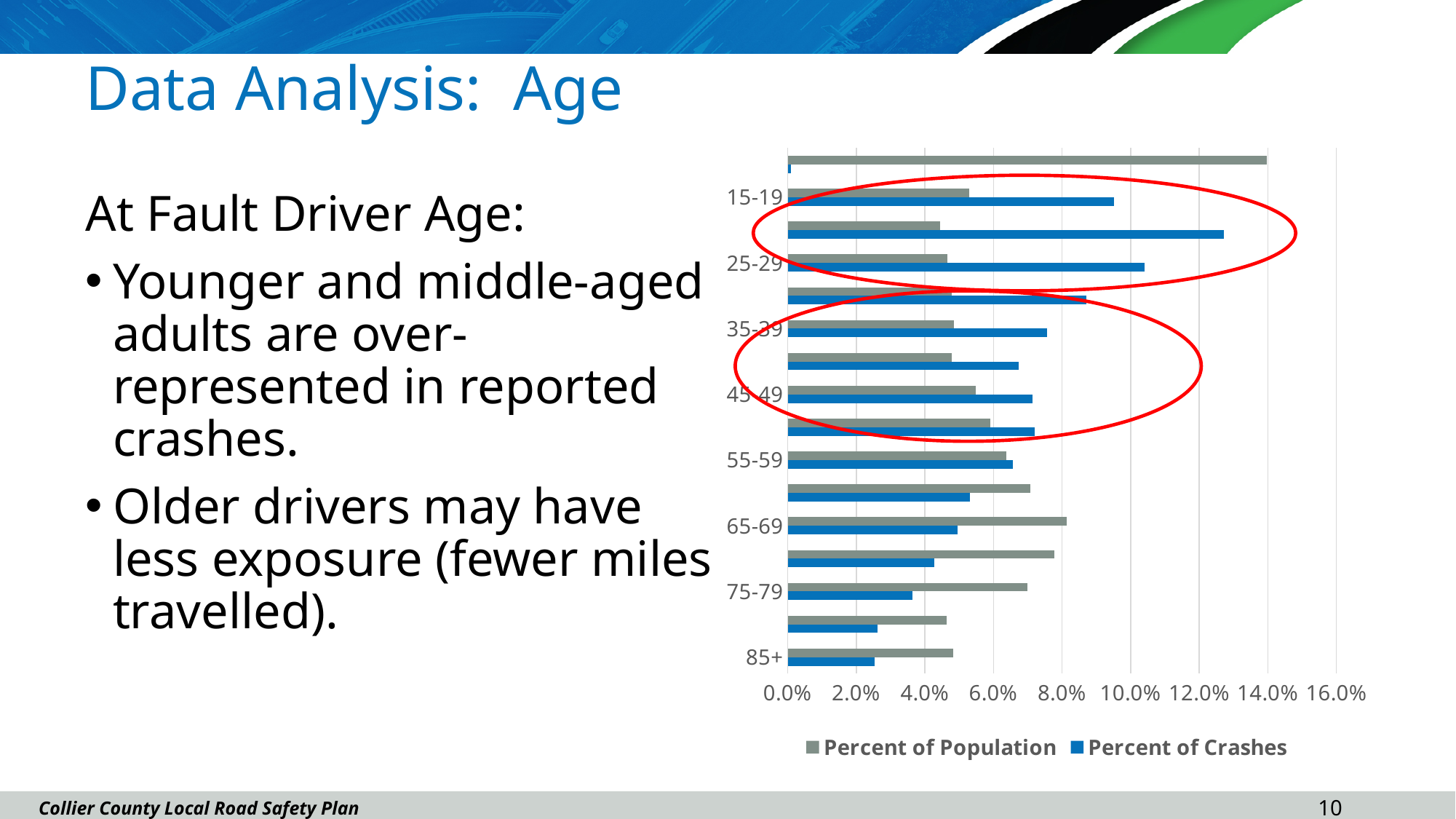
Moving from the 25-29 age group down to the 85+ age group, does the Percent of Crashes generally rise or fall? fall Is the Percent of Crashes value for the 85+ age group greater or less than 4.0%? less Is the Percent of Crashes value for the 15-19 age group greater or less than 8.0%? greater For the 15-19 age group, which is larger: Percent of Population or Percent of Crashes? Percent of Crashes Is the Percent of Crashes value for the 75-79 age group greater or less than 4.0%? less For the 85+ age group, which is larger: Percent of Population or Percent of Crashes? Percent of Population What kind of chart is shown on the slide? Bar chart Which series is shown in gray in the chart? Percent of Population Which series is shown in blue in the chart? Percent of Crashes How many series does the chart's legend list? 2